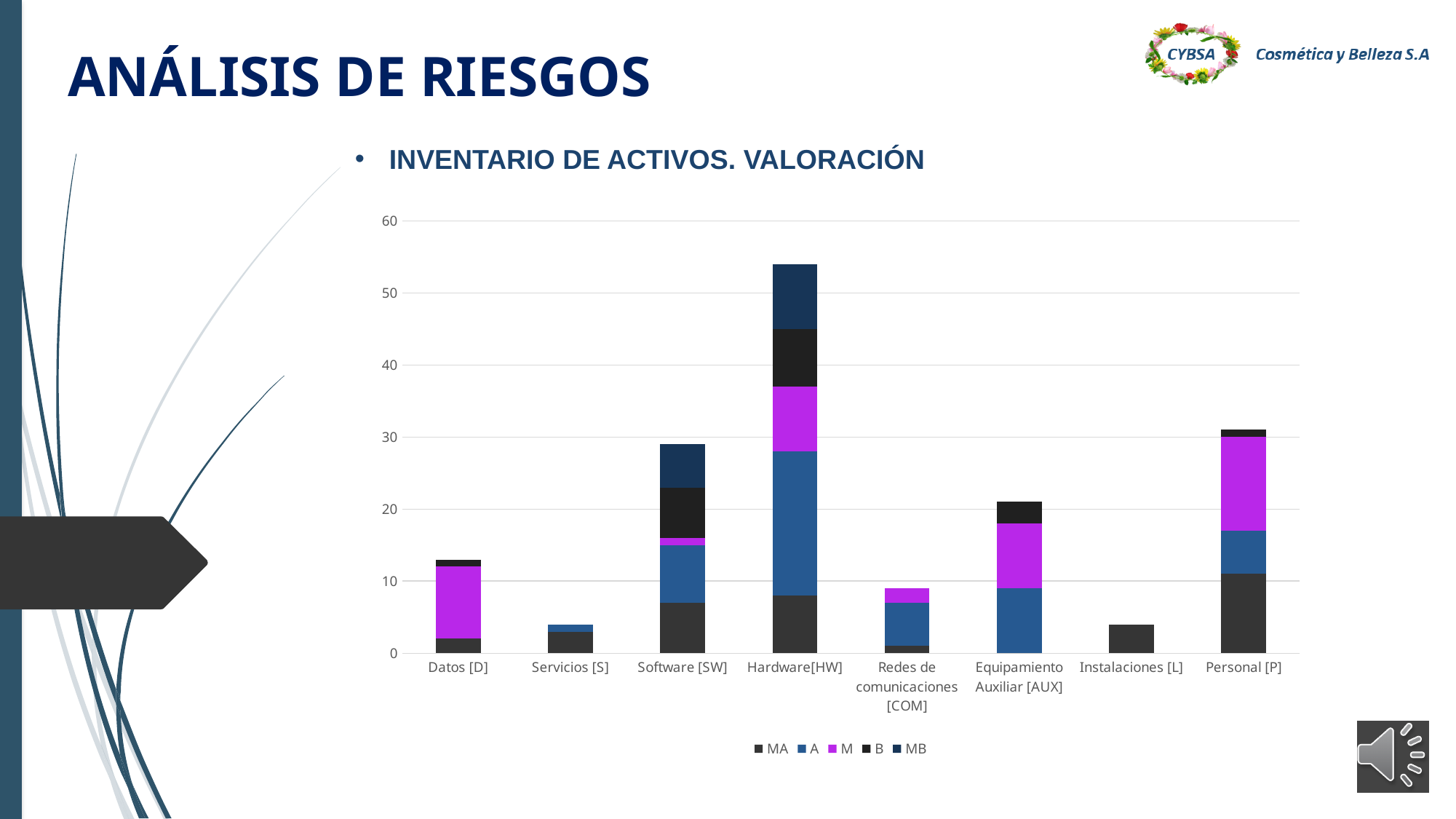
What is the heading shown above the chart? INVENTARIO DE ACTIVOS. VALORACIÓN Is the total stacked value for Datos [D] greater or less than 10? greater Is the total stacked value for Instalaciones [L] greater or less than 10? less Is the total stacked value for Hardware[HW] greater or less than 50? greater How many series does the chart legend list? 5 What are the series names listed in the chart legend? MA, A, M, B, MB How many asset categories are shown along the x axis of the chart? 8 Which category has the tallest stacked bar in the chart? Hardware[HW] Which has the larger total stacked value, Hardware[HW] or Software [SW]? Hardware[HW] What kind of chart is shown on the slide? Stacked bar chart Which has the larger total stacked value, Personal [P] or Equipamiento Auxiliar [AUX]? Personal [P]